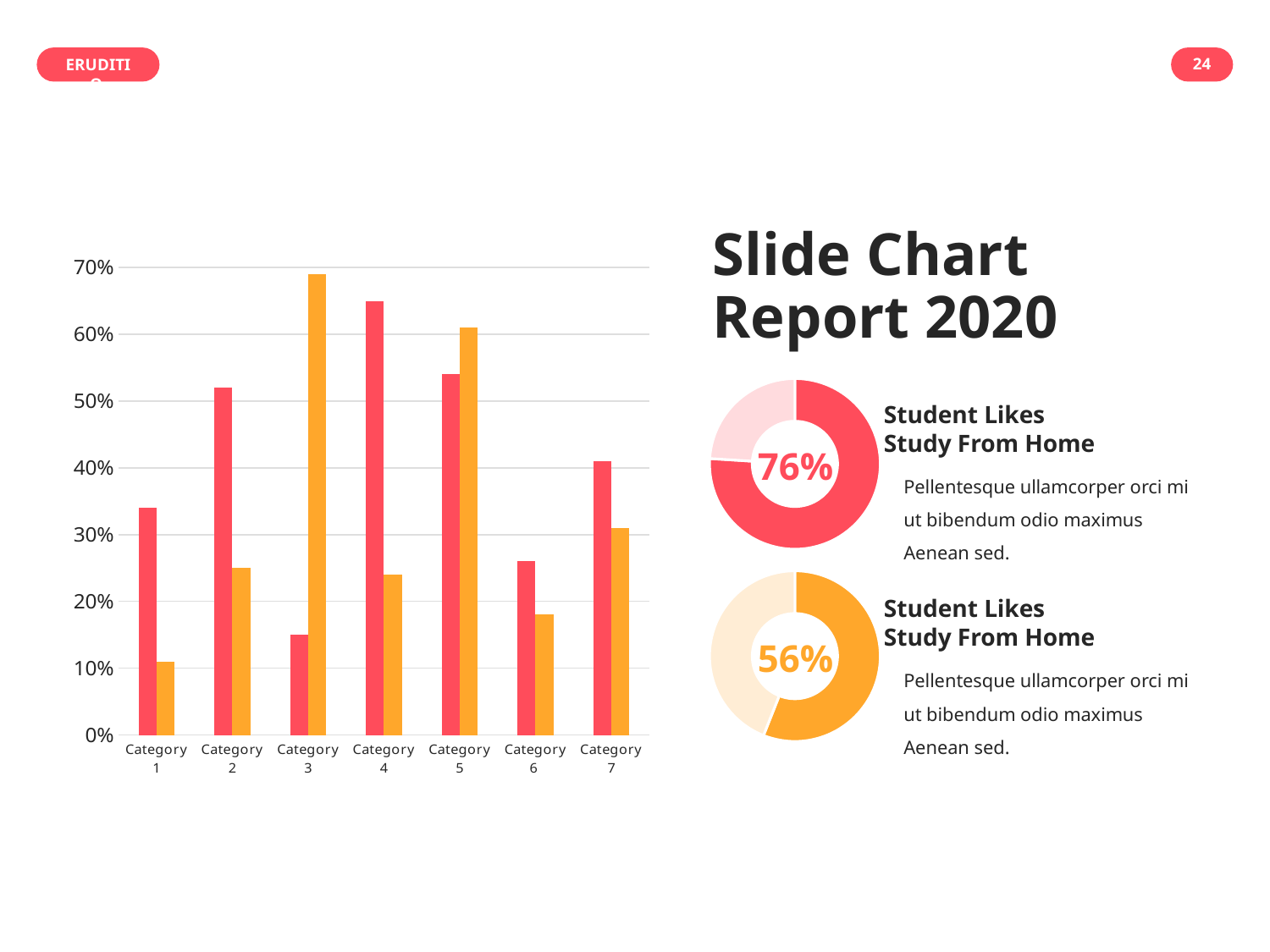
What percentage is shown in the upper donut chart on the right side of the slide? 76% In the bar chart on the left, which category has the tallest orange bar? Category 3 In the bar chart on the left, is the red bar for Category 2 greater or less than 50%? greater In the bar chart on the left, which category has the tallest red bar? Category 4 What percentage is shown in the lower donut chart on the right side of the slide? 56% In the bar chart on the left, is the orange bar for Category 1 greater or less than 20%? less In the bar chart on the left, which category has the shortest red bar? Category 3 How many categories does the bar chart on the left show? 7 In the bar chart on the left, is the red bar for Category 4 greater or less than 60%? greater What kind of chart is shown on the left side of the slide? bar chart In the bar chart on the left, which category has the shortest orange bar? Category 1 In the bar chart on the left, which is taller for Category 3, the red bar or the orange bar? the orange bar